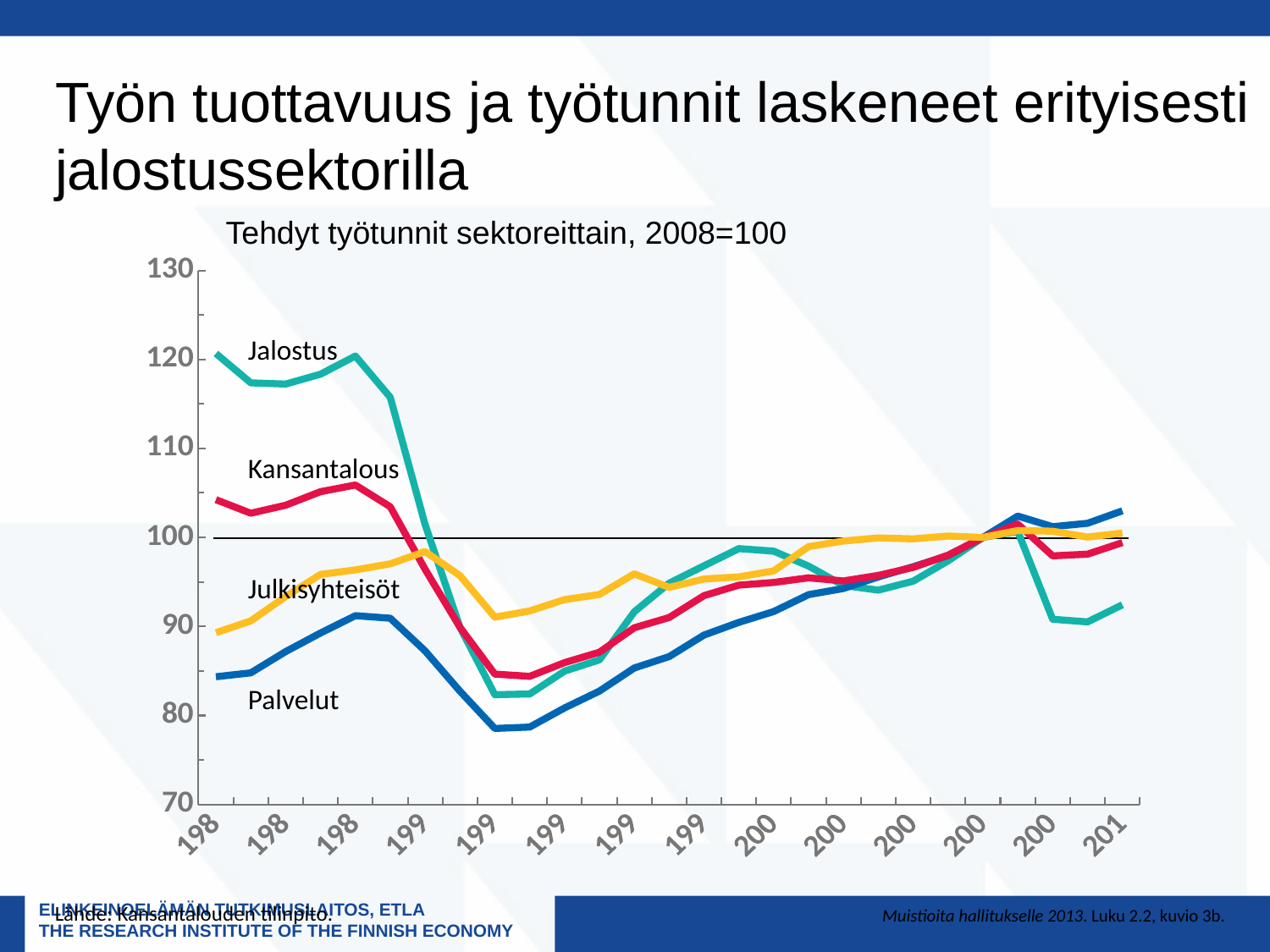
Does the Jalostus line overall rise or fall from the left end to the right end of the chart? fall What kind of chart is shown on the slide? line chart Which series has the lowest value at the left end of the chart? Palvelut Is the value for Julkisyhteisöt at the left end of the chart greater or less than 100? less Which series has the highest value at the left end of the chart? Jalostus What is the highest value shown on the y axis? 130 Is the value for Kansantalous at the left end of the chart greater or less than 100? greater What is the title of the chart? Tehdyt työtunnit sektoreittain, 2008=100 Is the lowest point of the Palvelut line greater or less than 80? less How many series are plotted in the chart? 4 At the right end of the chart, which is higher, Palvelut or Jalostus? Palvelut